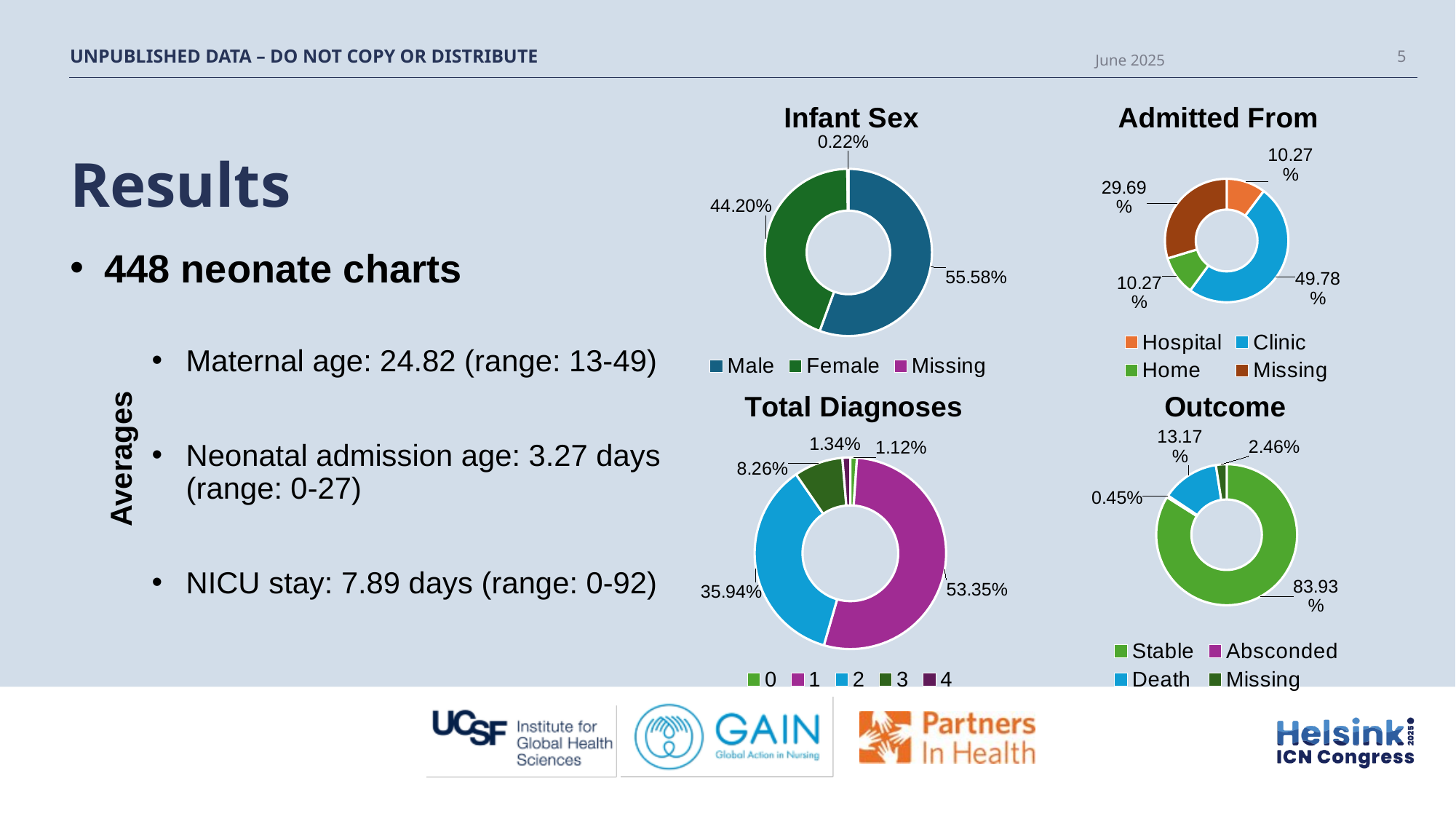
In the Outcome chart, what percentage of neonates died? 13.17% In the Total Diagnoses chart, which is larger: the share for 2 diagnoses or the share for 3 diagnoses? 2 diagnoses In the Admitted From chart, what percentage of neonates were admitted from a clinic? 49.78% In the Infant Sex chart, what is the difference between the Male and Female shares? 11.38% In the Outcome chart, what percentage of neonates had a Stable outcome? 83.93% How many categories does the legend of the Admitted From chart list? 4 In the Admitted From chart, which category has the largest share? Clinic In the Infant Sex chart, what percentage is labelled Missing? 0.22% In the Infant Sex chart, what percentage of neonates were male? 55.58% What type of chart is used for the Outcome data? Donut (pie) chart In the Admitted From chart, what percentage is labelled Missing? 29.69% In the Total Diagnoses chart, what percentage of neonates had 1 diagnosis? 53.35%